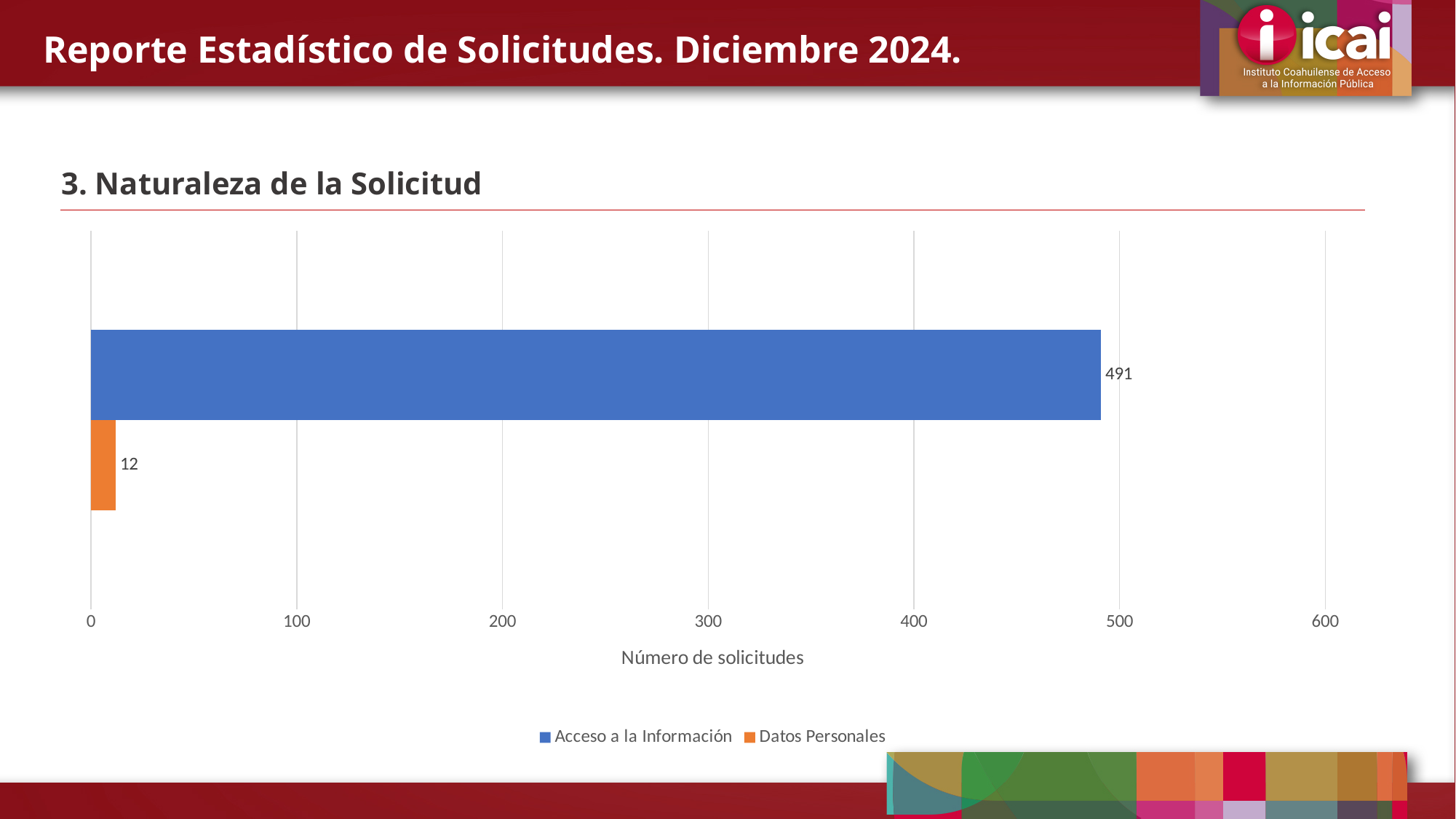
What is the label of the horizontal axis? Número de solicitudes Which series has the highest value? Acceso a la Información Which series has the lowest value? Datos Personales Which is larger, Acceso a la Información or Datos Personales? Acceso a la Información What is the value for Acceso a la Información? 491 What is the difference between the values for Acceso a la Información and Datos Personales? 479 What is the total of the two values shown in the chart? 503 What is the value for Datos Personales? 12 Is the value for Datos Personales greater or less than 100? less What kind of chart is shown on the slide? bar chart How many series does the legend list? 2 Is the value for Acceso a la Información greater or less than 400? greater